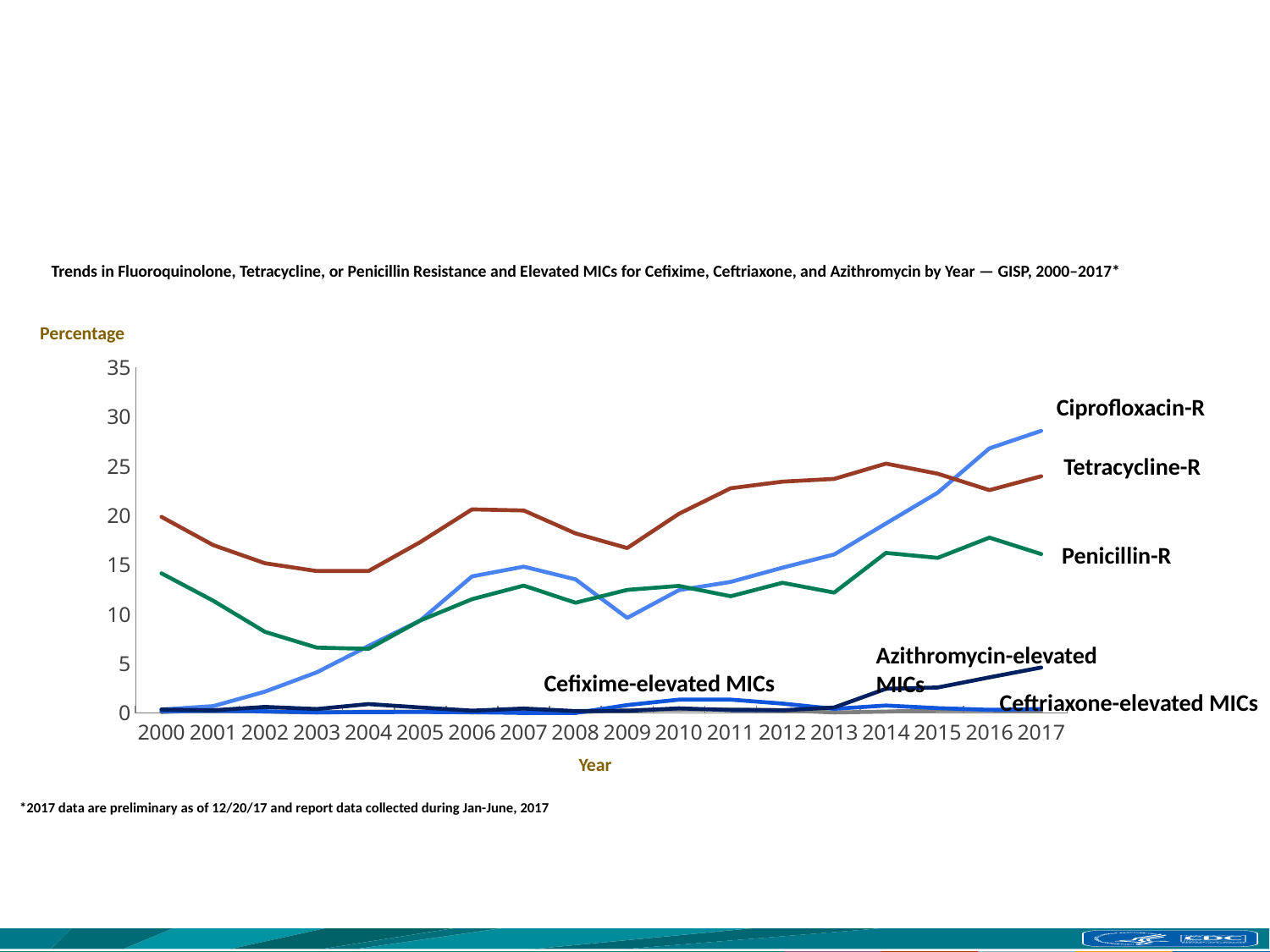
What kind of chart is shown on the slide? line chart Does the Ciprofloxacin-R line rise or fall from 2009 to 2017? rises Is the value for Ciprofloxacin-R in 2017 greater or less than 25? greater Is the value for Penicillin-R in 2003 greater or less than 10? less What is the label on the y axis of the chart? Percentage How many years are shown along the x axis of the chart? 18 In 2000, which is higher: Tetracycline-R or Penicillin-R? Tetracycline-R In 2017, which is higher: Ciprofloxacin-R or Tetracycline-R? Ciprofloxacin-R How many series are labelled on the chart? 6 Which series has the highest value in 2017? Ciprofloxacin-R Is the value for Tetracycline-R in 2000 greater or less than 15? greater